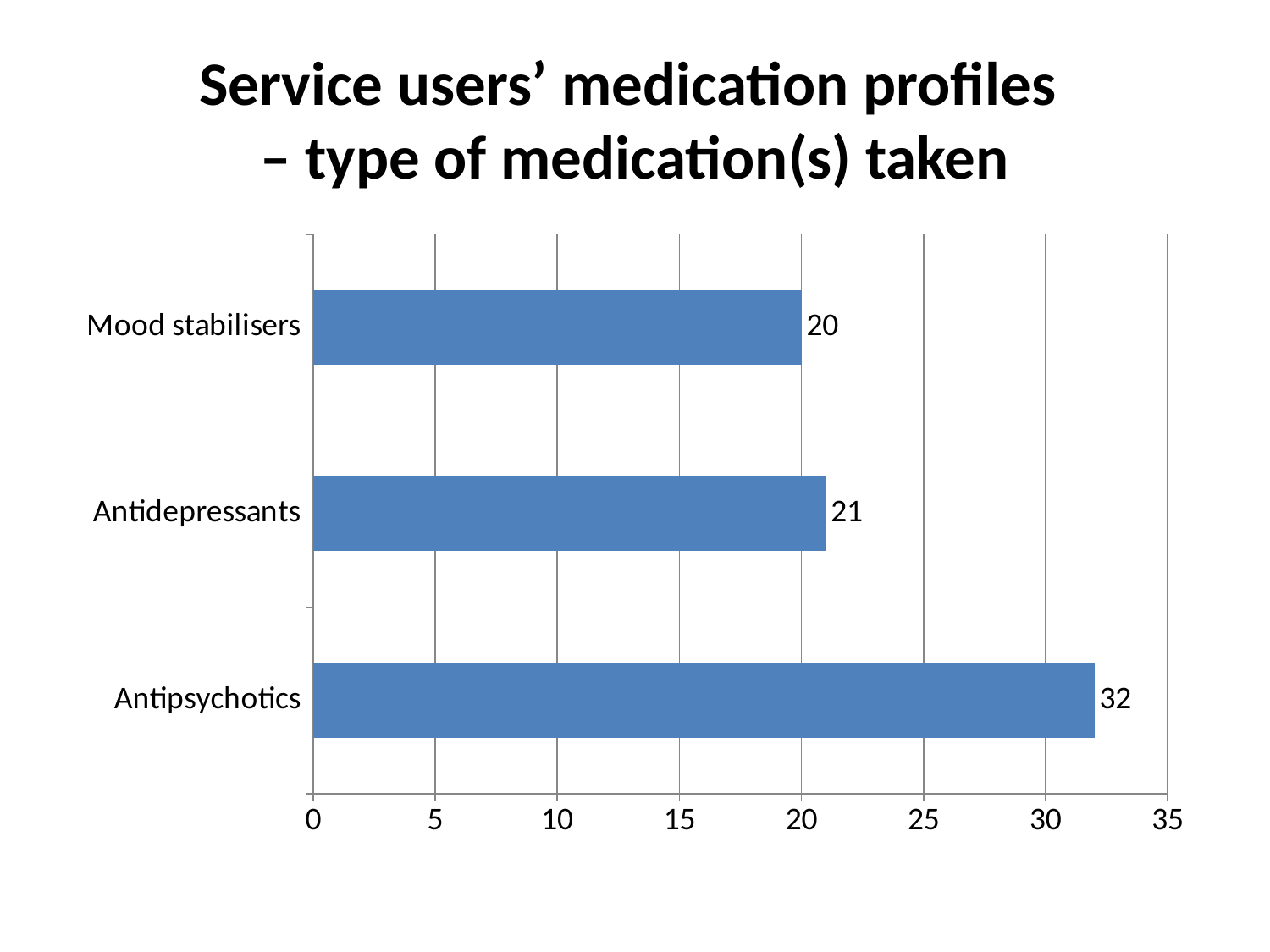
Which type of medication has the lowest value? Mood stabilisers Is the value for Antipsychotics greater or less than 30? greater Which is larger, the value for Antipsychotics or the value for Mood stabilisers? Antipsychotics What is the value for Antidepressants? 21 What kind of chart is shown on the slide? Bar chart What is the value for Mood stabilisers? 20 What is the value for Antipsychotics? 32 How many categories are shown in the chart? 3 Which type of medication has the highest value? Antipsychotics What is the title of the chart on the slide? Service users' medication profiles – type of medication(s) taken What is the difference between the values for Antipsychotics and Antidepressants? 11 What is the difference between the values for Antidepressants and Mood stabilisers? 1